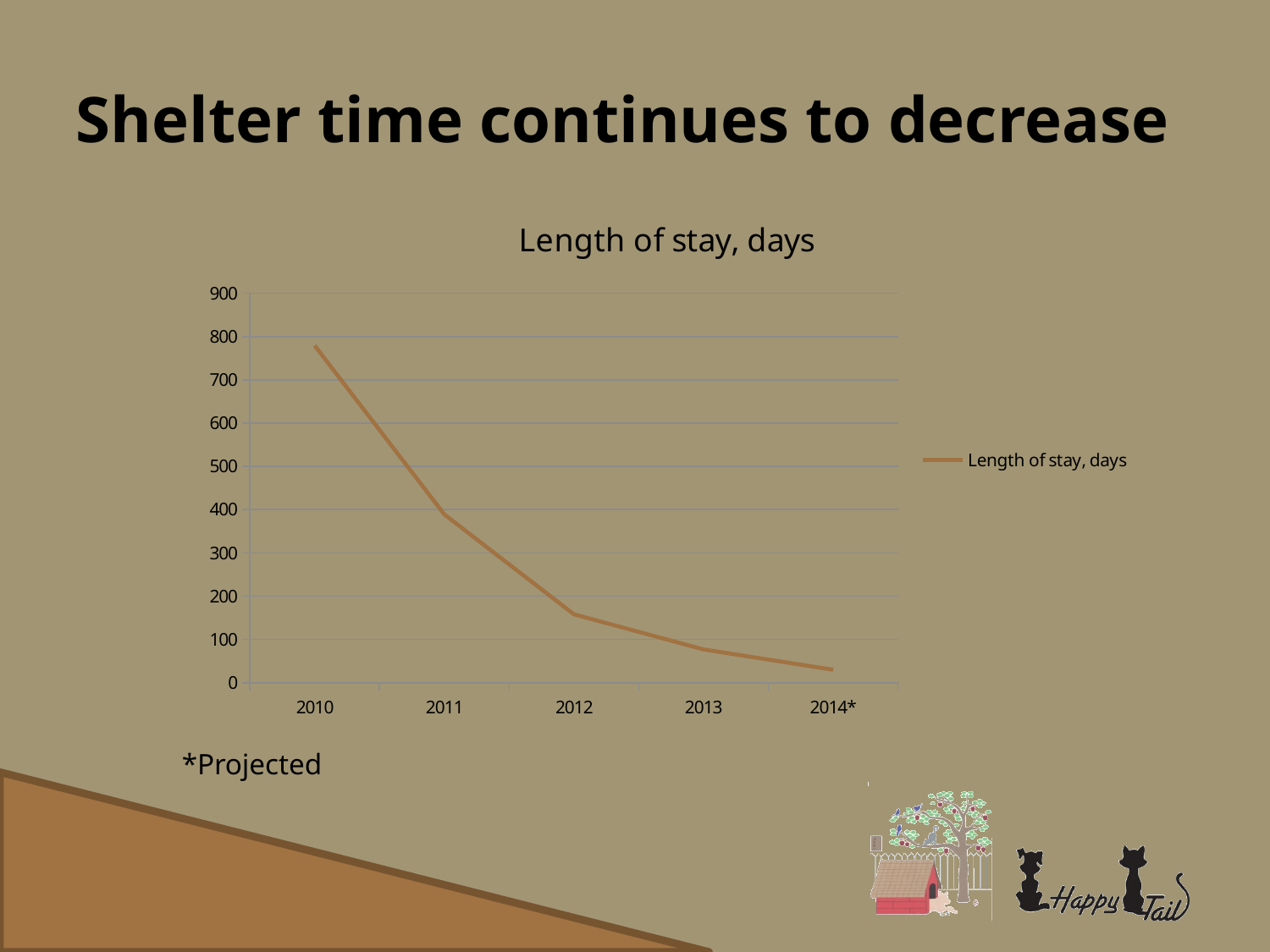
Which is larger, the value for 2011 or the value for 2013? 2011 Do the values rise or fall from 2010 to 2014*? fall Is the value for 2012 greater or less than 200? less How many series does the legend list? 1 Is the value for 2010 greater or less than 700? greater Is the value for 2011 greater or less than 500? less What is the title of the chart? Length of stay, days Which year has the highest length of stay? 2010 What kind of chart is shown on the slide? line chart How many years are plotted along the x axis? 5 Which year has the lowest length of stay? 2014*